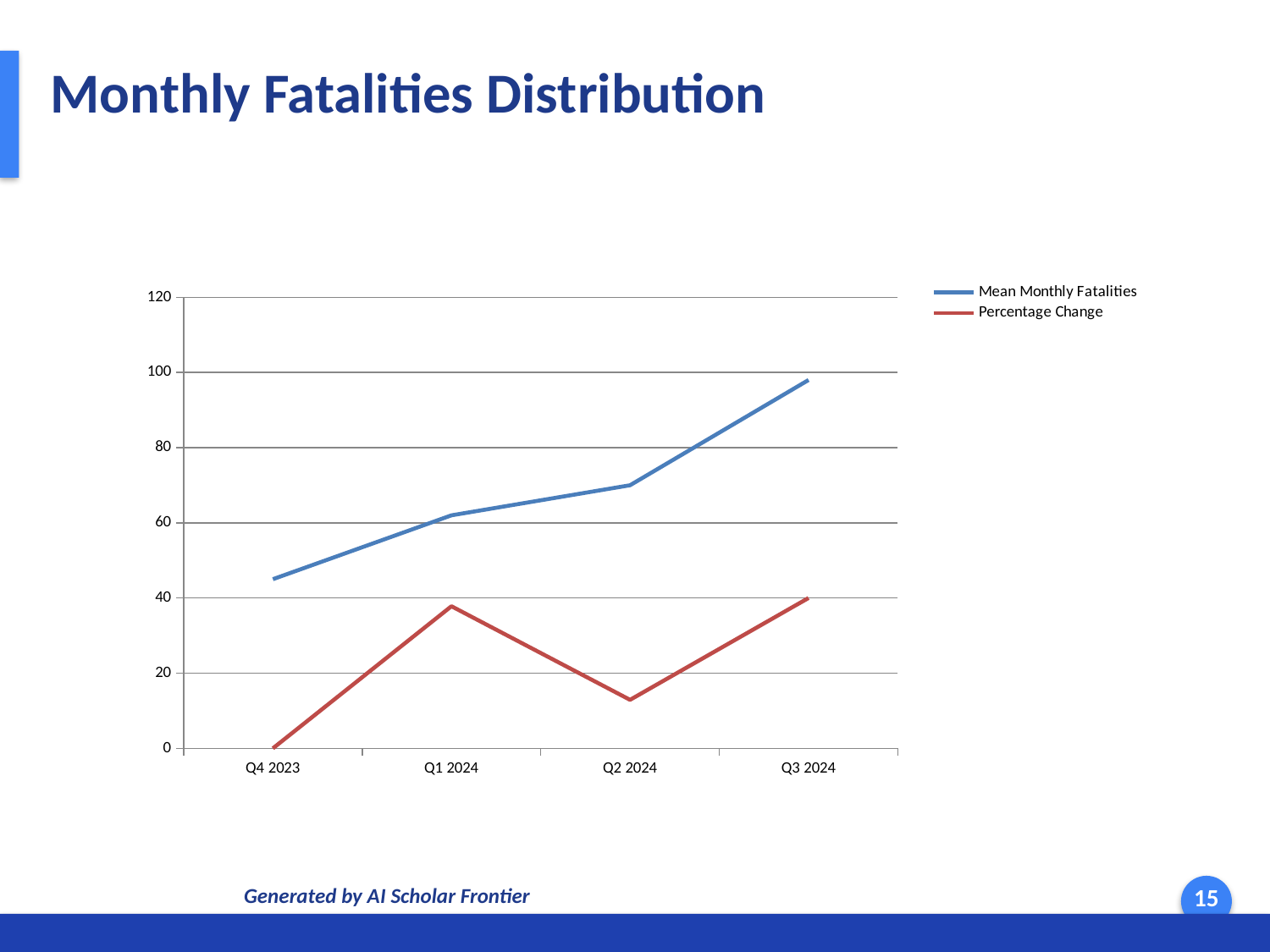
How many quarters are plotted along the x axis? 4 Is the Mean Monthly Fatalities value for Q4 2023 greater or less than 60? less What colour is the line for Percentage Change? red What kind of chart is shown on the slide? line chart How many series does the legend list? 2 Do the Mean Monthly Fatalities rise or fall from Q4 2023 to Q3 2024? rise Which quarter has the lowest Percentage Change? Q4 2023 Is the Mean Monthly Fatalities value for Q3 2024 greater or less than 80? greater Which quarter has the lowest Mean Monthly Fatalities? Q4 2023 Which quarter has the highest Mean Monthly Fatalities? Q3 2024 Is the Percentage Change value for Q2 2024 greater or less than 20? less Which is larger in Q1 2024, Mean Monthly Fatalities or Percentage Change? Mean Monthly Fatalities